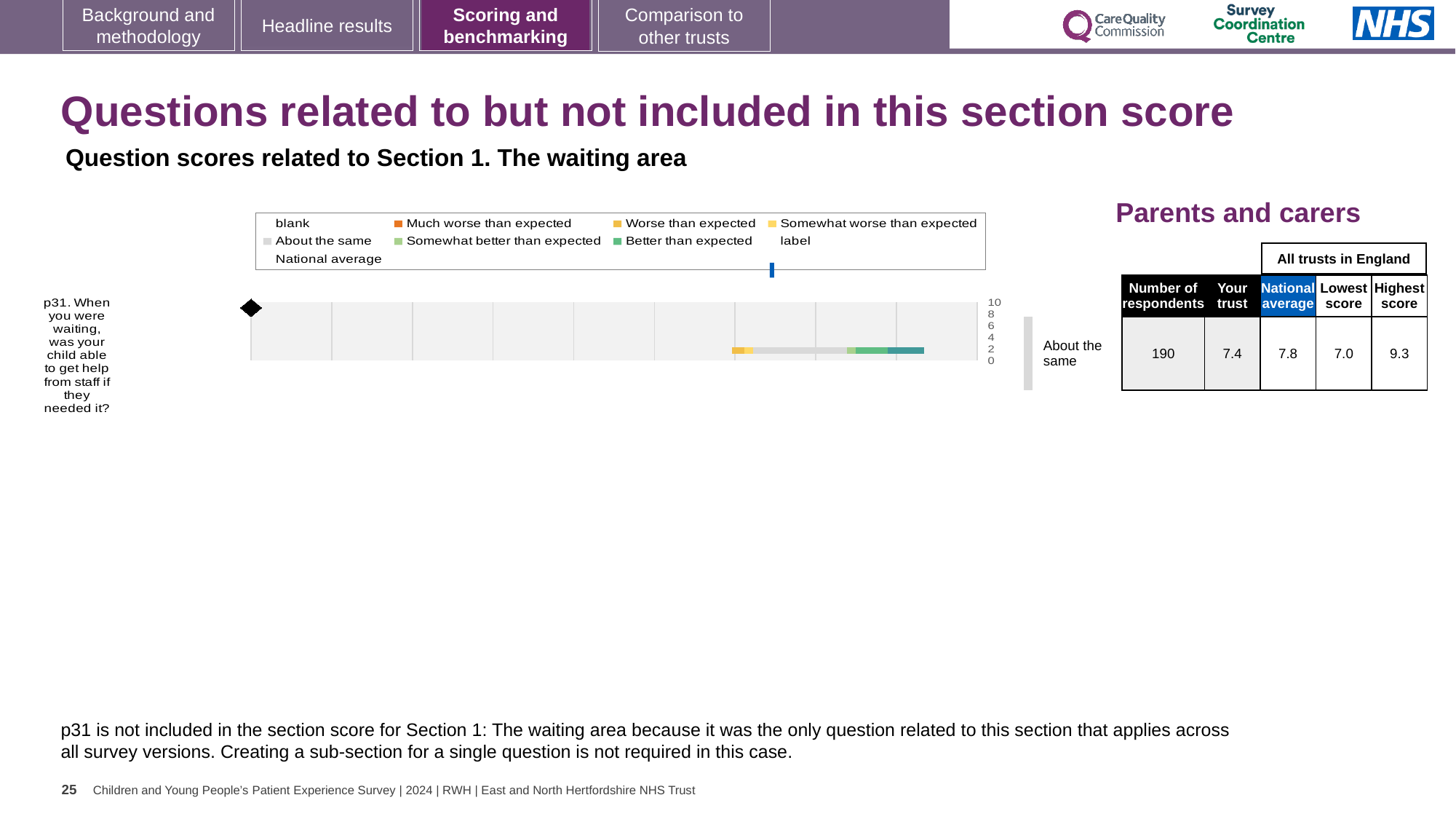
Which benchmark category label is shown to the right of the p31 bar? About the same What is the highest score among all trusts in England for p31? 9.3 How many entries does the chart legend list? 9 What colour is the legend marker for 'Much worse than expected'? orange What is the lowest score among all trusts in England for p31? 7.0 What is the difference between the highest score and the lowest score for p31? 2.3 What is the national average score for p31? 7.8 Which is larger for p31, the 'Your trust' score or the national average? National average What is the 'Your trust' score for p31 in the Parents and carers table? 7.4 What kind of chart is used to show the p31 question score? bar chart How many respondents answered p31? 190 How many questions are plotted in the chart? 1